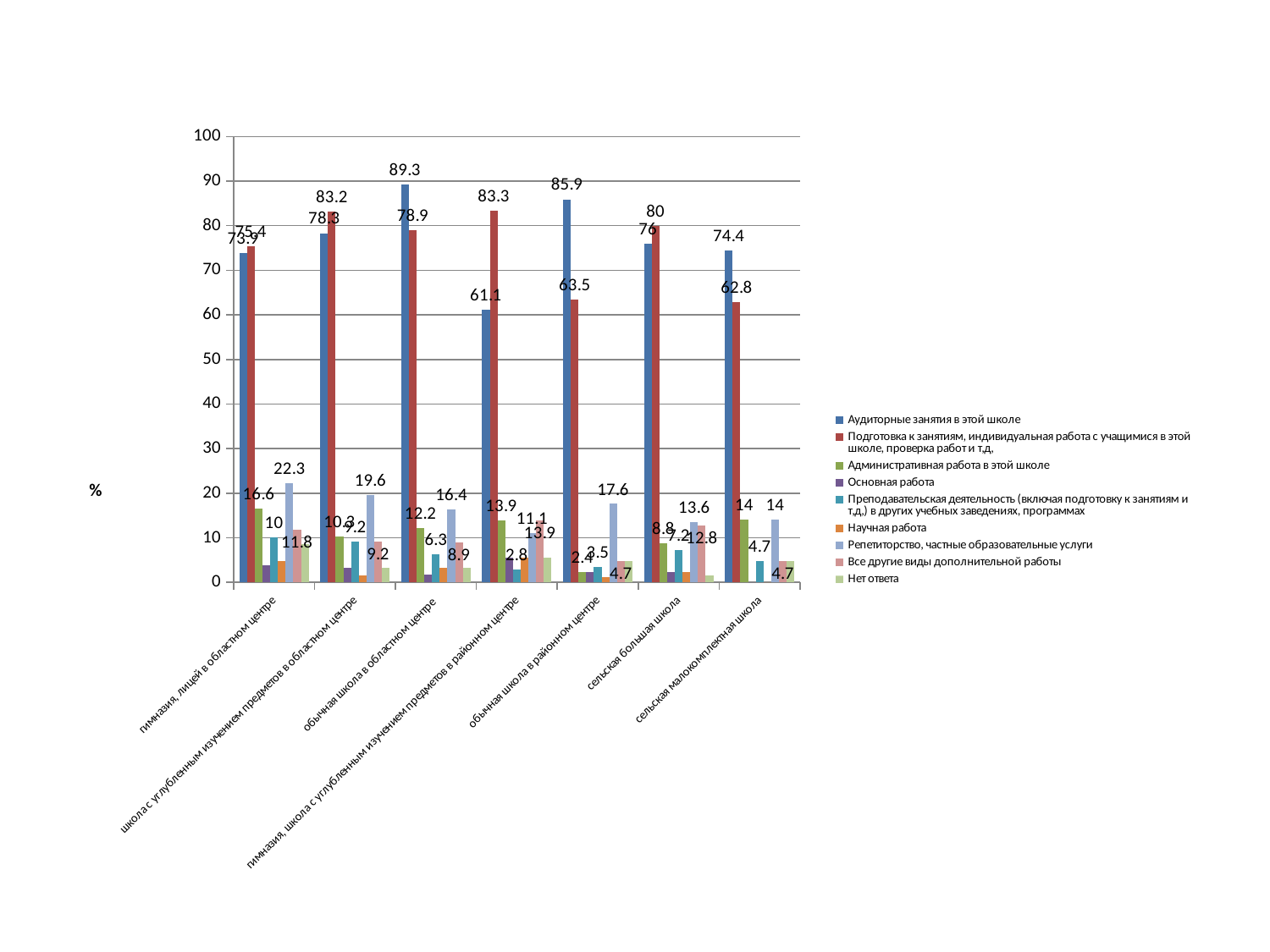
Which category has the lowest value for 'Аудиторные занятия в этой школе'? гимназия, школа с углубленным изучением предметов в районном центре What is the value of 'Аудиторные занятия в этой школе' for 'обычная школа в областном центре'? 89.3 What is the value of 'Репетиторство, частные образовательные услуги' for 'гимназия, лицей в областном центре'? 22.3 Which category has the highest value for 'Репетиторство, частные образовательные услуги'? гимназия, лицей в областном центре What is the value of 'Подготовка к занятиям...' for 'сельская малокомплектная школа'? 62.8 How many series does the legend list? 9 For 'сельская большая школа', what is the difference between 'Подготовка к занятиям...' (80) and 'Аудиторные занятия в этой школе' (76)? 4 Which category has the highest value for 'Аудиторные занятия в этой школе'? обычная школа в областном центре For 'обычная школа в районном центре', which is larger: 'Аудиторные занятия в этой школе' or 'Подготовка к занятиям...'? Аудиторные занятия в этой школе What unit label is shown on the vertical axis? % How many school-type categories are shown on the x axis? 7 What kind of chart is shown on the slide? bar chart